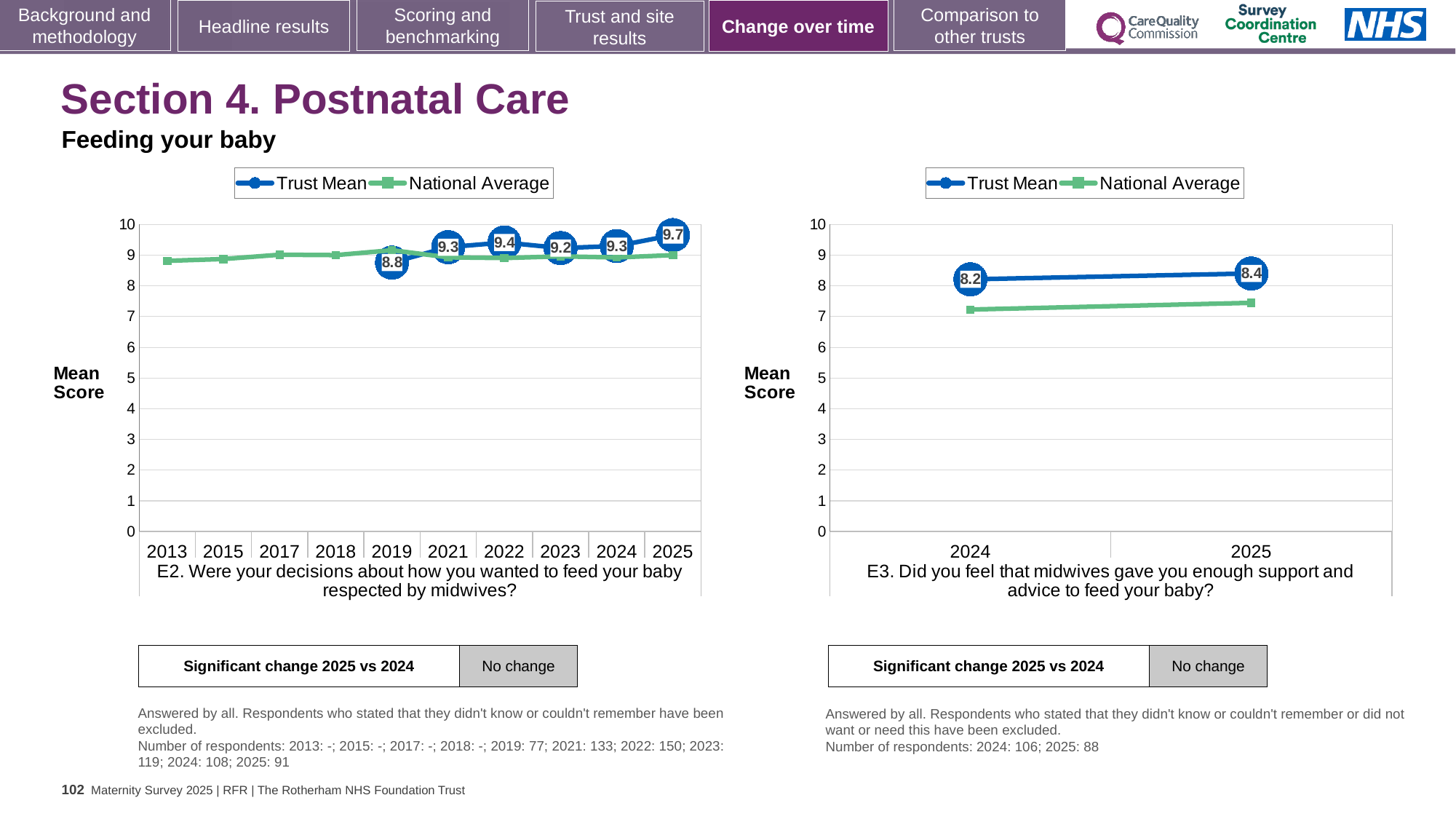
In the E2 chart (left), how many years are shown on the x axis? 10 In the E2 chart (left), what is the difference between the Trust Mean values for 2025 and 2024? 0.4 In the E2 chart (left), which year has the highest Trust Mean value? 2025 In the E2 chart (left), what is the Trust Mean value for 2025? 9.7 In the E2 chart (left), is the National Average value for 2013 greater or less than 8? greater In the E2 chart (left), what is the Trust Mean value for 2019? 8.8 In the E3 chart (right), is the National Average value for 2024 greater or less than 8? less In the E3 chart (right), is the Trust Mean for 2025 higher or lower than the National Average for 2025? higher In the E3 chart (right), what is the Trust Mean value for 2024? 8.2 How many series does the legend of the E3 chart (right) list? 2 In the E3 chart (right), what is the Trust Mean value for 2025? 8.4 In the E2 chart (left), which year has the lowest labelled Trust Mean value? 2019